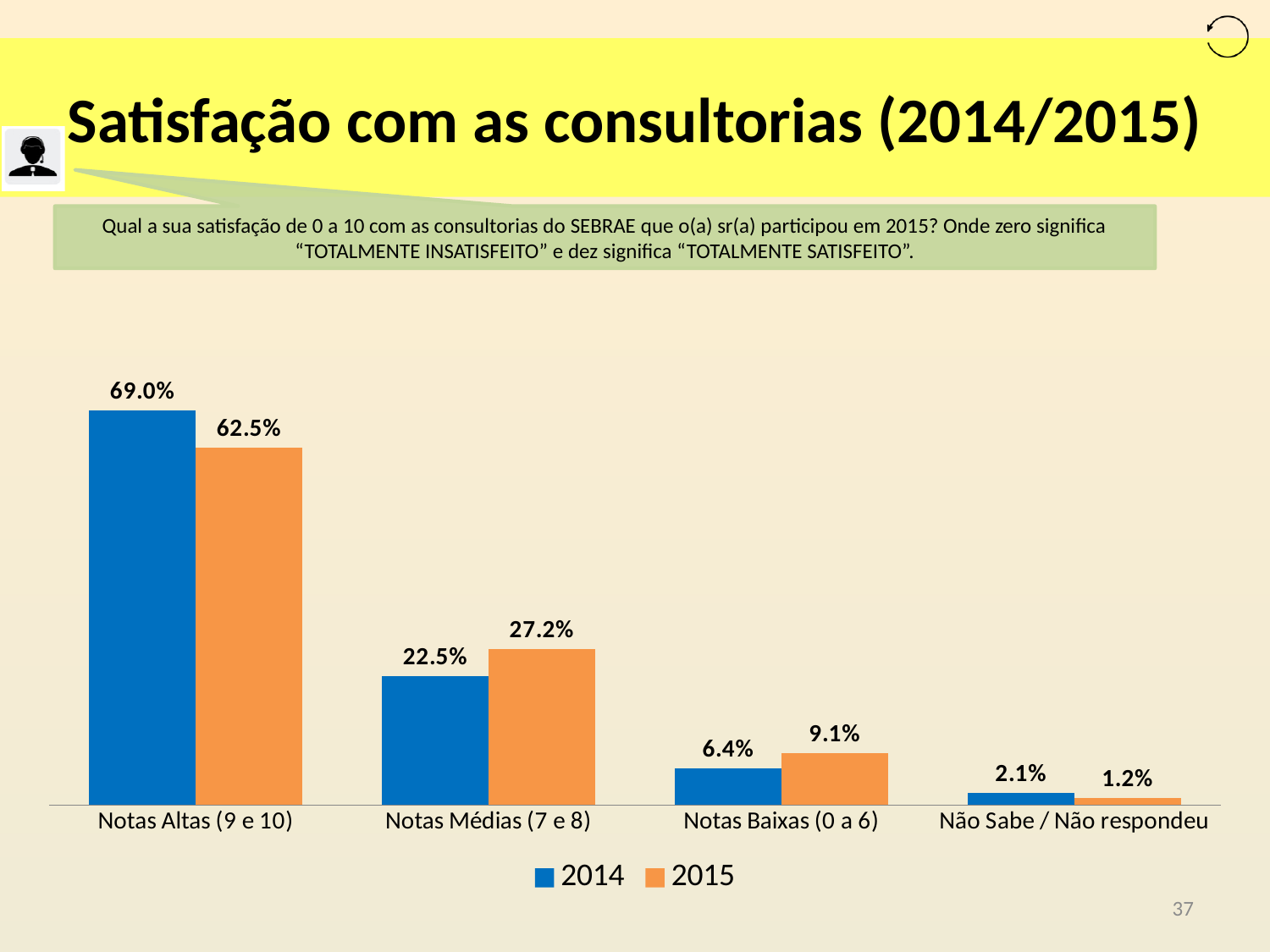
What kind of chart is shown on the slide? Bar chart How many categories are shown on the x axis? 4 Which category has the highest value for 2015? Notas Altas (9 e 10) Which category has the lowest value for 2014? Não Sabe / Não respondeu Which is larger for Notas Médias (7 e 8): the 2014 value or the 2015 value? 2015 What is the difference between the 2014 and 2015 values for Notas Altas (9 e 10)? 6.5% What is the difference between the 2015 and 2014 values for Notas Baixas (0 a 6)? 2.7% What is the value for 2015 in the Não Sabe / Não respondeu category? 1.2% Which colour represents the 2015 series in the legend? Orange What is the value for 2014 in the Notas Altas (9 e 10) category? 69.0% What is the value for 2015 in the Notas Médias (7 e 8) category? 27.2% How many series does the legend list? 2